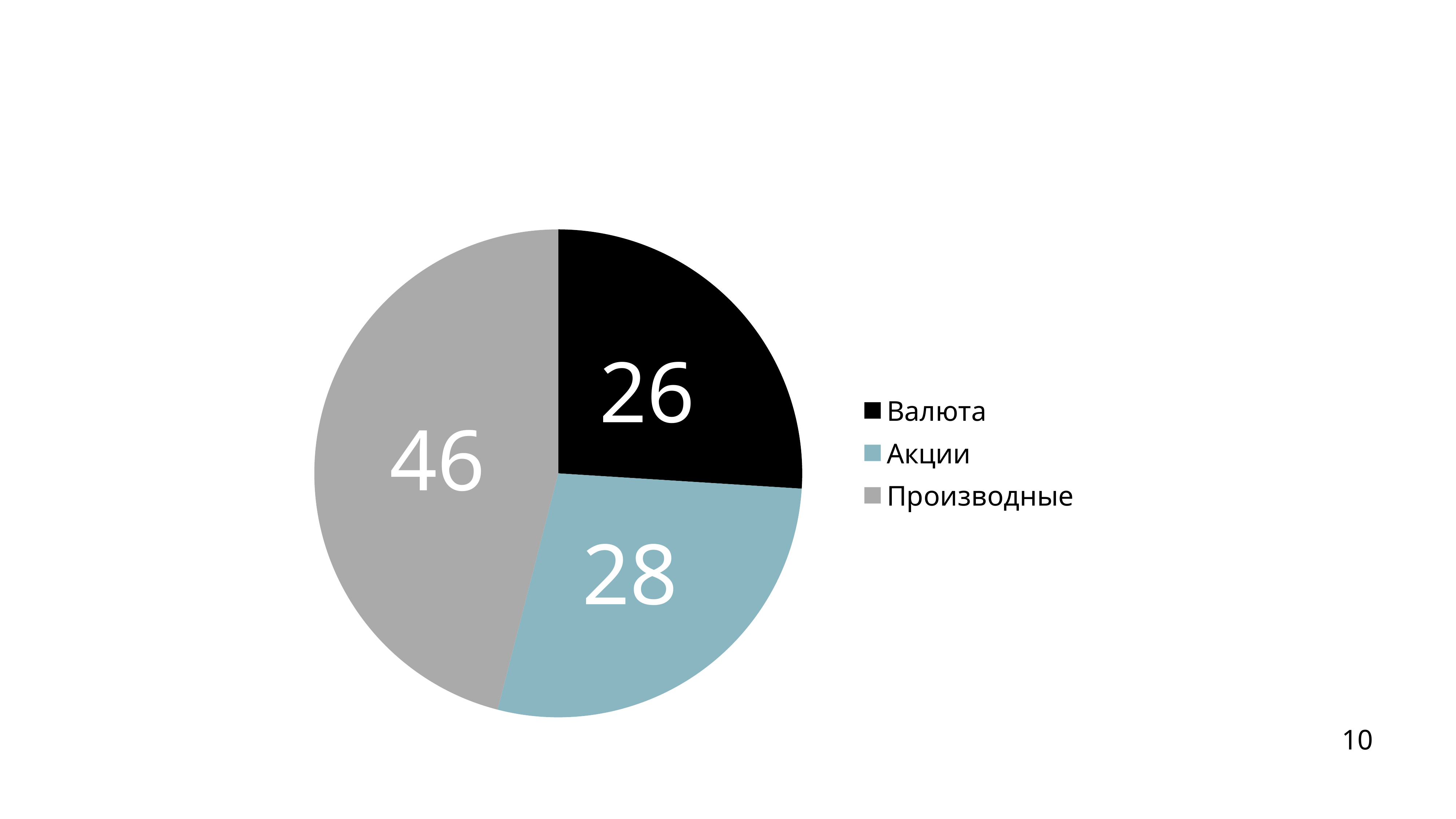
What is the difference between the values for Производные and Акции? 18 Which is larger, the value for Производные or the value for Валюта? Производные What is the value for Валюта? 26 What is the value for Производные? 46 Which category has the largest slice? Производные What is the difference between the values for Акции and Валюта? 2 What is the total of all the slice values? 100 What is the value for Акции? 28 What colour is the slice for Акции? light blue Which category has the smallest slice? Валюта How many slices does the pie chart have? 3 What kind of chart is shown on the slide? pie chart